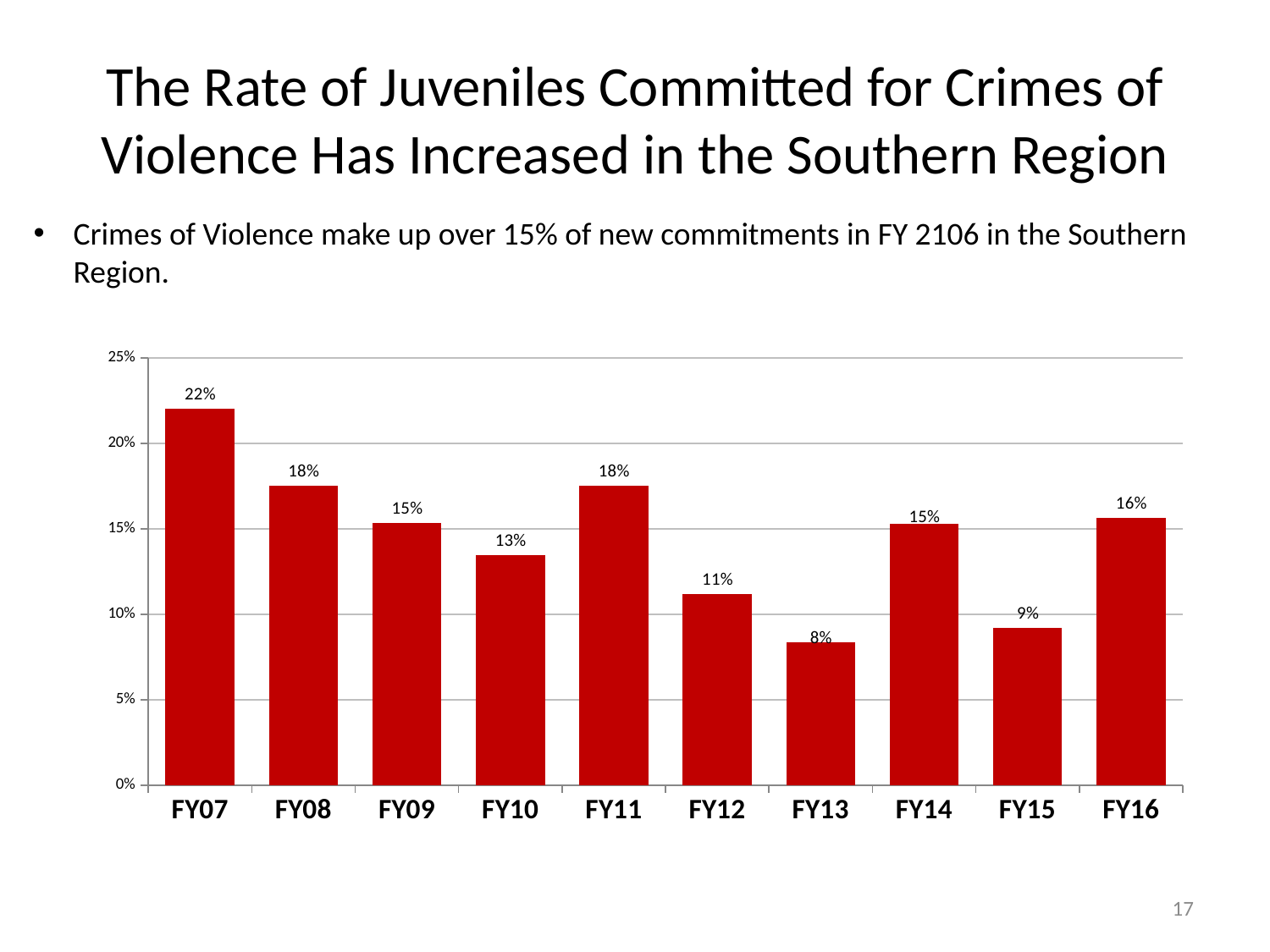
How many fiscal years are shown on the x axis? 10 Which fiscal year has the lowest value? FY13 What is the difference between the values for FY16 and FY15? 7% What is the value for FY10? 13% Is the value for FY11 greater or less than 15%? greater What kind of chart is shown on the slide? Bar chart What is the value for FY13? 8% What is the value for FY07? 22% What is the difference between the values for FY07 and FY13? 14% What is the value for FY16? 16% Which fiscal year has the highest value? FY07 Which is larger, the value for FY12 or the value for FY14? FY14